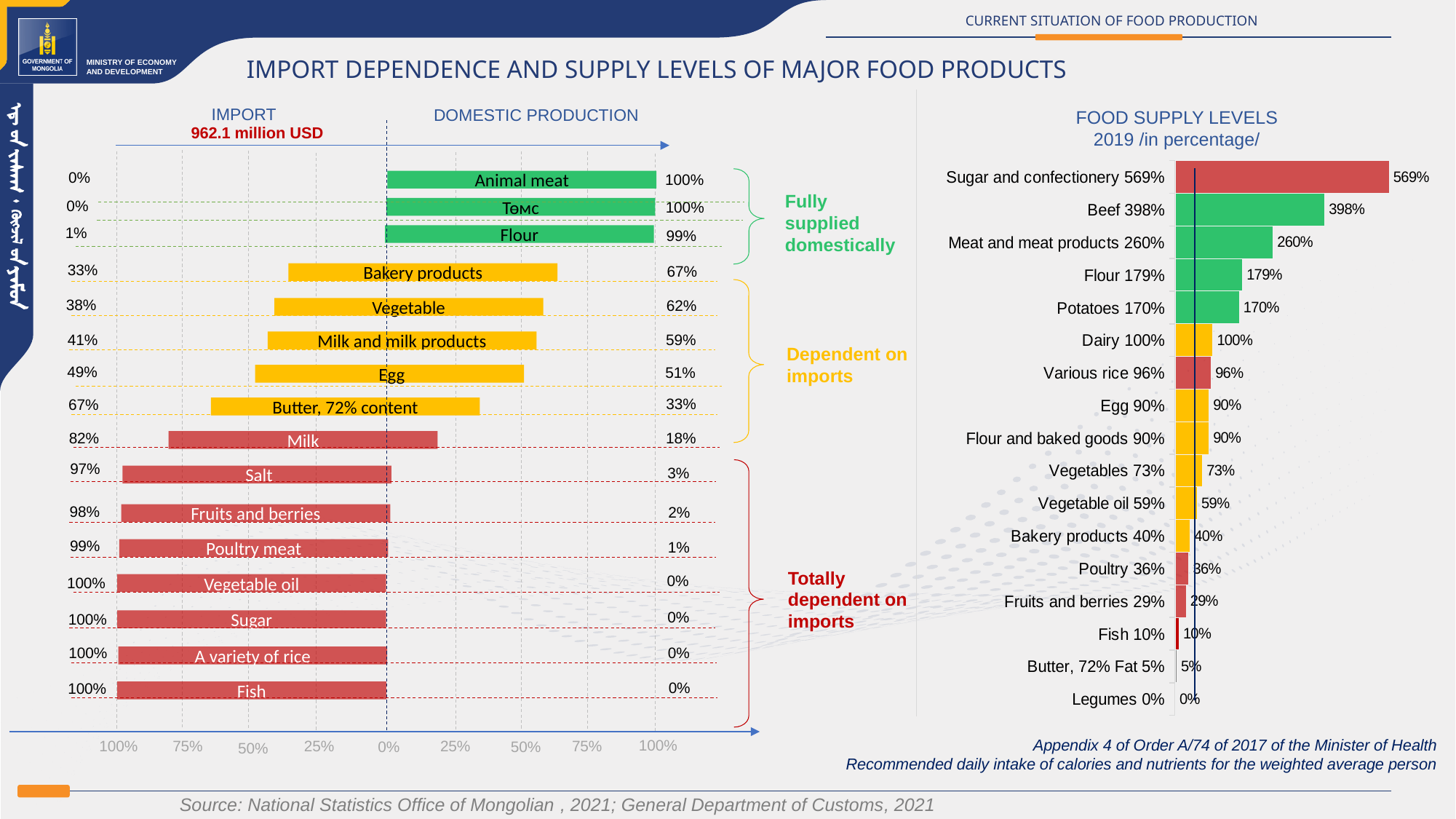
In the import dependence chart on the left, how many food products are listed? 16 In the Food Supply Levels chart on the right, what is the difference between Meat and meat products and Flour? 81% In the Food Supply Levels chart on the right, what is the difference between the values for Flour and Potatoes? 9% In the import dependence chart on the left, what is the import share for Butter, 72% content? 67% In the import dependence chart on the left, what total import value is shown under the IMPORT heading? 962.1 million USD In the Food Supply Levels chart on the right, what is the value for Beef? 398% In the import dependence chart on the left, what is the domestic production share for Egg? 51% In the import dependence chart on the left, which has the larger domestic production share, Vegetable or Milk and milk products? Vegetable In the Food Supply Levels chart on the right, which category has the highest value? Sugar and confectionery In the Food Supply Levels chart on the right, which category has the lowest value? Legumes In the Food Supply Levels chart on the right, how many categories are shown? 17 What kind of chart is the import dependence chart on the left? Bar chart